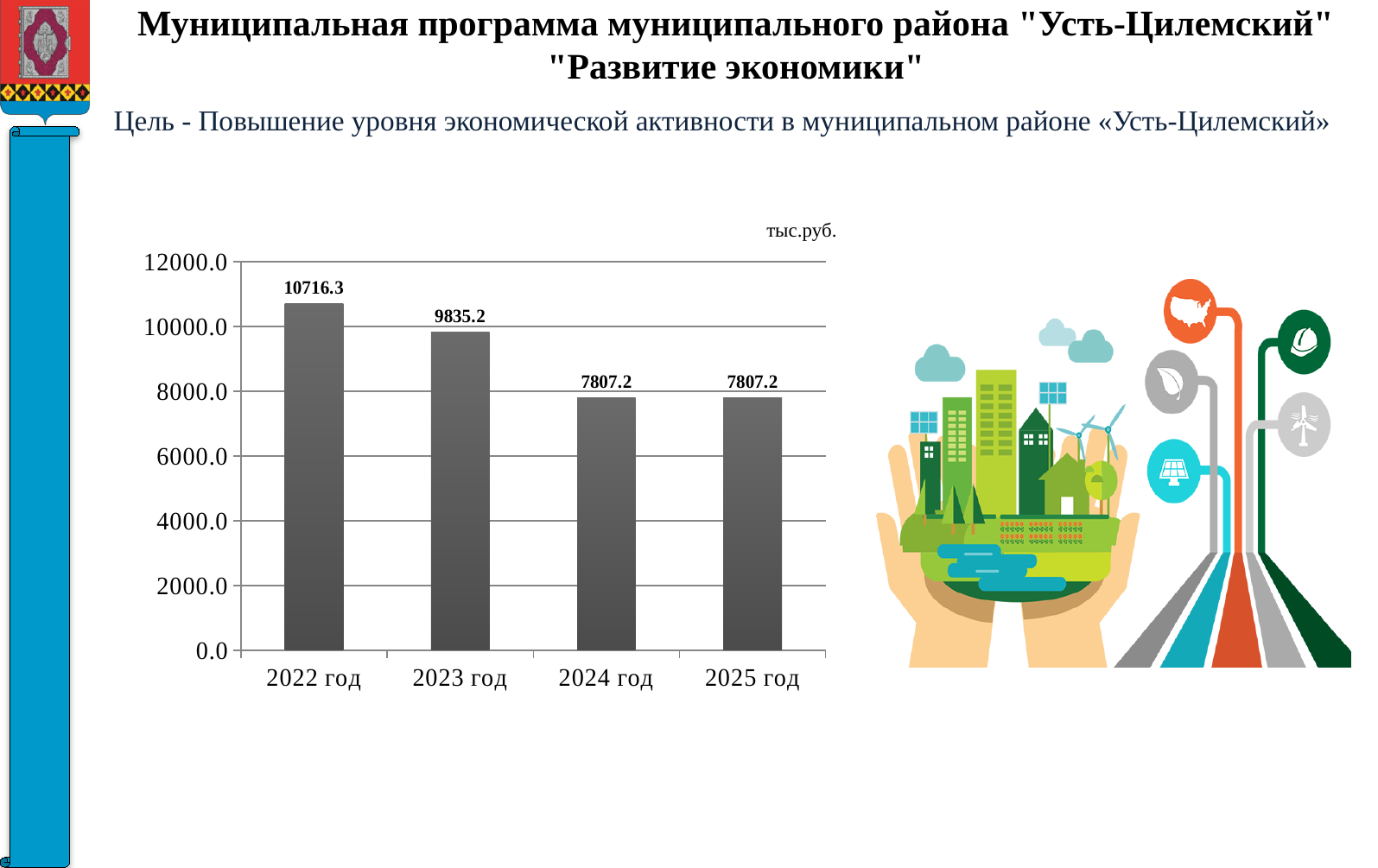
What is the value for 2023 год? 9835.2 Do the values rise or fall from 2022 год to 2024 год? fall What is the difference between the values for 2022 год and 2023 год? 881.1 What unit is indicated above the chart? тыс.руб. What kind of chart is shown on the slide? bar chart Is the value for 2023 год greater or less than 10000.0? less What is the value for 2022 год? 10716.3 Which is larger, the value for 2022 год or the value for 2025 год? 2022 год How many years are shown on the x axis? 4 Which year has the highest value? 2022 год What is the value for 2024 год? 7807.2 What is the difference between the values for 2023 год and 2024 год? 2028.0